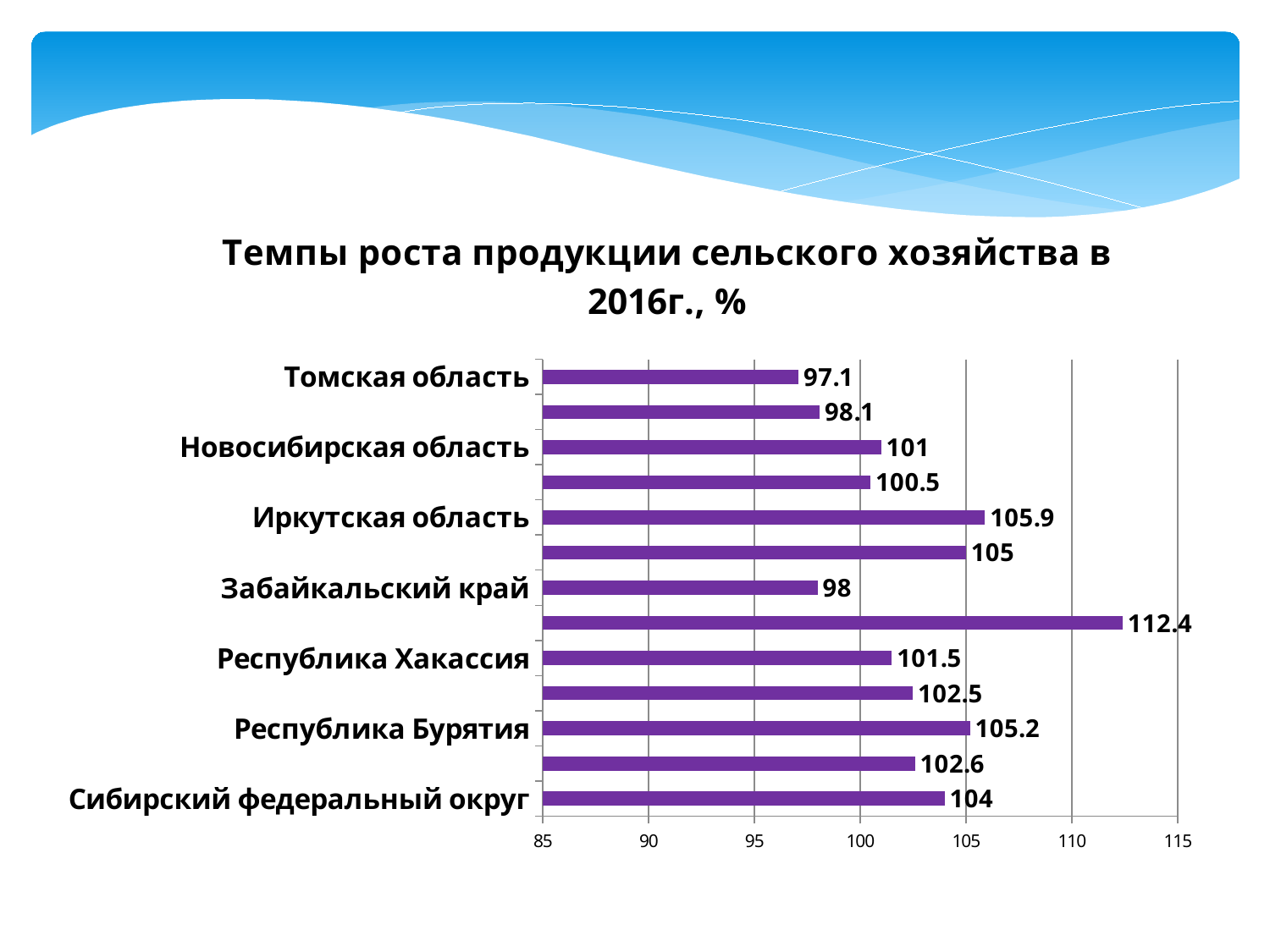
What is the value for Сибирский федеральный округ? 104 Which is larger, the value for Новосибирская область or the value for Республика Хакассия? Республика Хакассия What is the title of the chart? Темпы роста продукции сельского хозяйства в 2016г., % What kind of chart is shown on the slide? bar chart What is the value for Республика Бурятия? 105.2 Is the value for Забайкальский край greater or less than 100? less What is the value for Иркутская область? 105.9 What is the difference between the values for Иркутская область and Забайкальский край? 7.9 What is the value for Томская область? 97.1 What is the largest value shown on the chart? 112.4 Which of the labelled regions has the lowest value? Томская область How many bars are plotted on the chart? 13